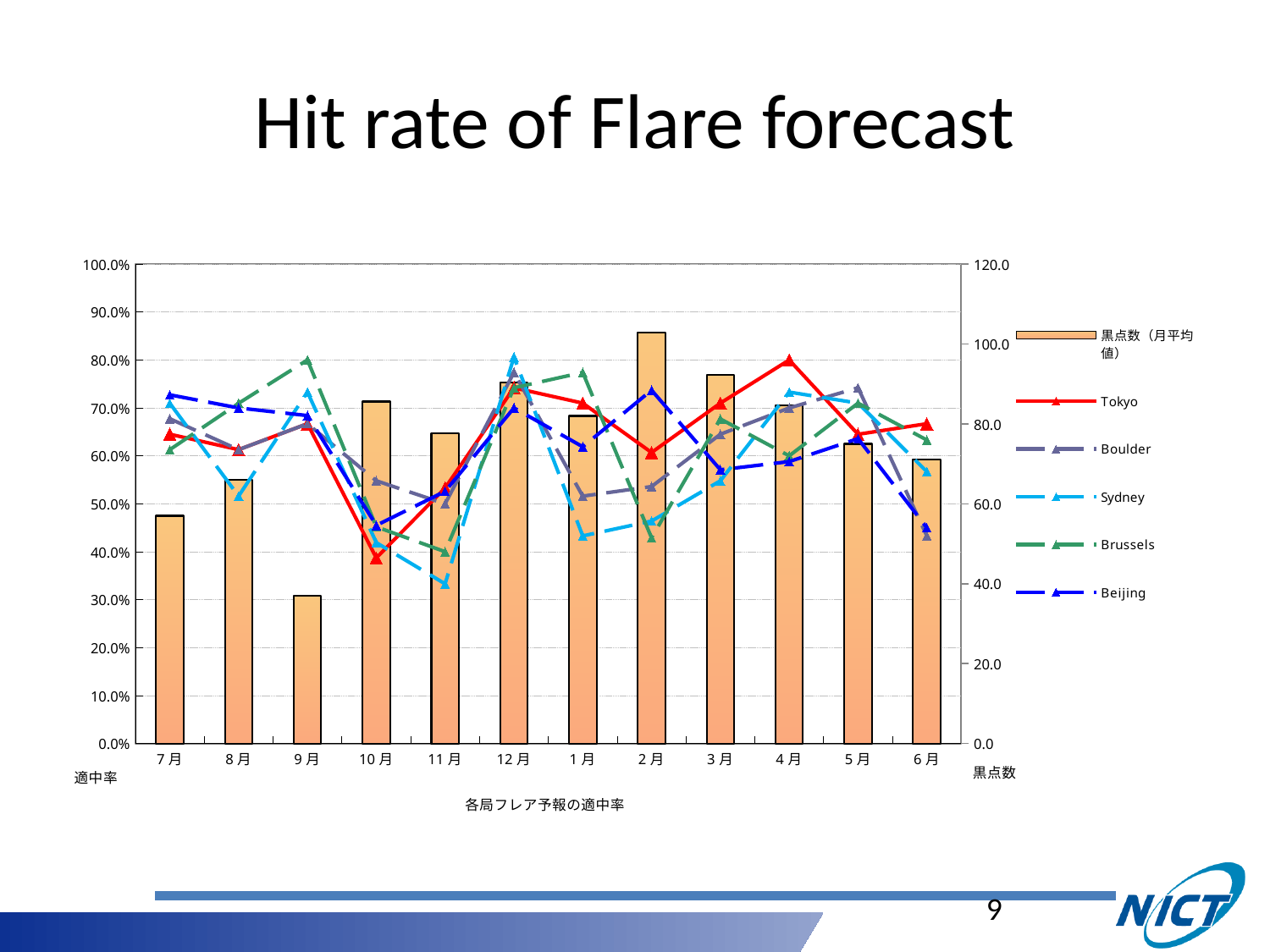
Is the Tokyo hit rate for 4月 greater or less than 70.0%? greater How many series does the chart's legend list? 6 Is the bar value for 9月 greater or less than 60.0 on the right axis? less How many months are shown on the x axis of the chart? 12 Which month has the shortest bar (黒点数)? 9月 In 2月, which has the higher hit rate, Tokyo or Brussels? Tokyo Is the bar value for 2月 greater or less than 80.0 on the right axis? greater What kind of chart is shown on the slide? A combined bar and line chart What colour is the Tokyo line in the chart? Red Which month has the tallest bar (黒点数)? 2月 Do the bar values rise or fall from 2月 to 6月? fall